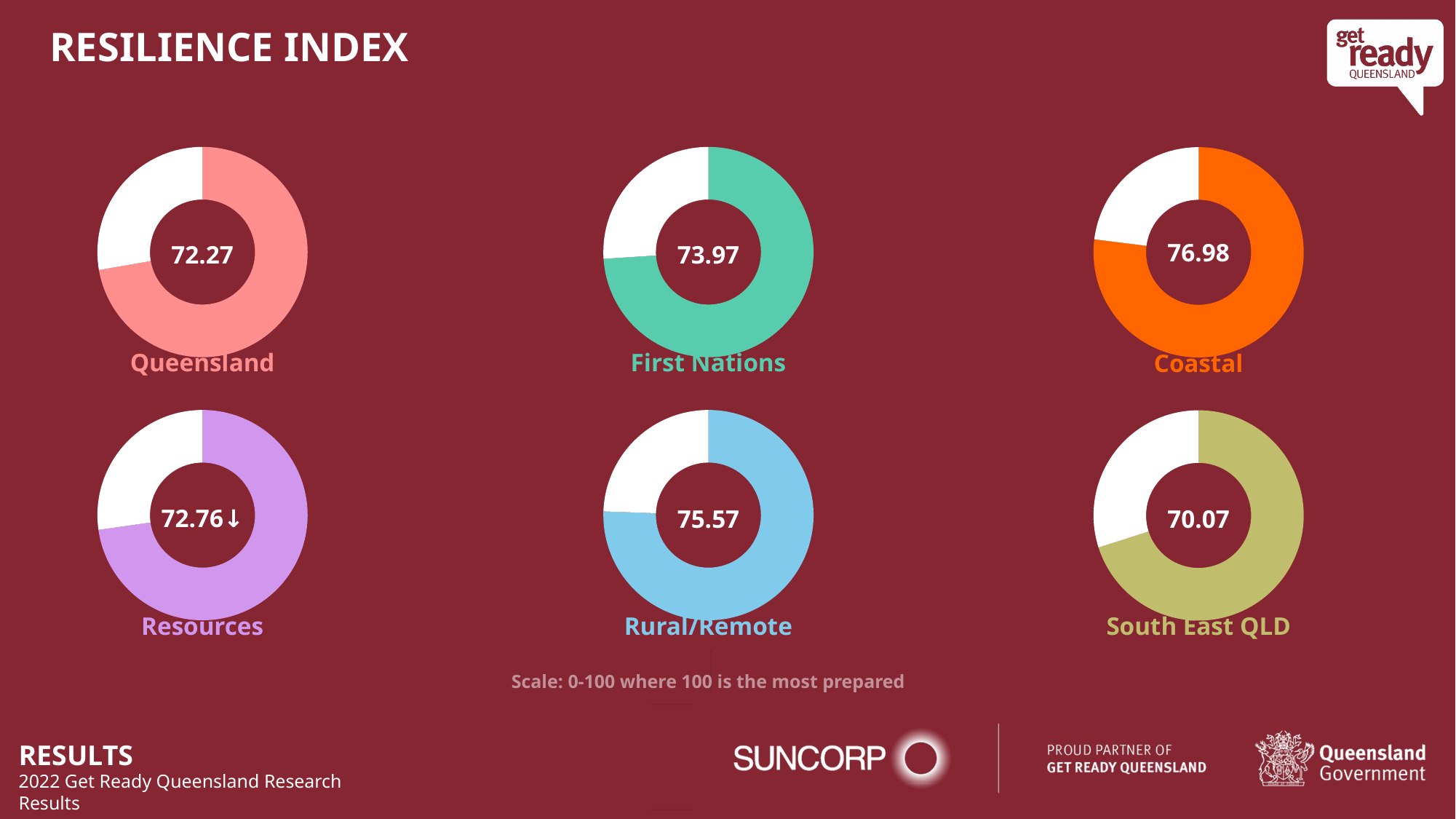
What value is shown in the Rural/Remote donut chart? 75.57 Which has the larger value, the Rural/Remote chart or the First Nations chart? Rural/Remote Across the six donut charts, which group has the lowest resilience index value? South East QLD What kind of chart is used to display each group's resilience index? Donut (pie) chart What value is shown in the Coastal donut chart? 76.98 How many donut charts are shown on the slide? 6 What is the difference between the Coastal value and the South East QLD value? 6.91 What is the resilience index value shown in the Queensland donut chart? 72.27 What value is shown in the South East QLD donut chart? 70.07 Across the six donut charts, which group has the highest resilience index value? Coastal What value is shown in the First Nations donut chart? 73.97 According to the note below the charts, what scale are the resilience index values on? 0-100 where 100 is the most prepared